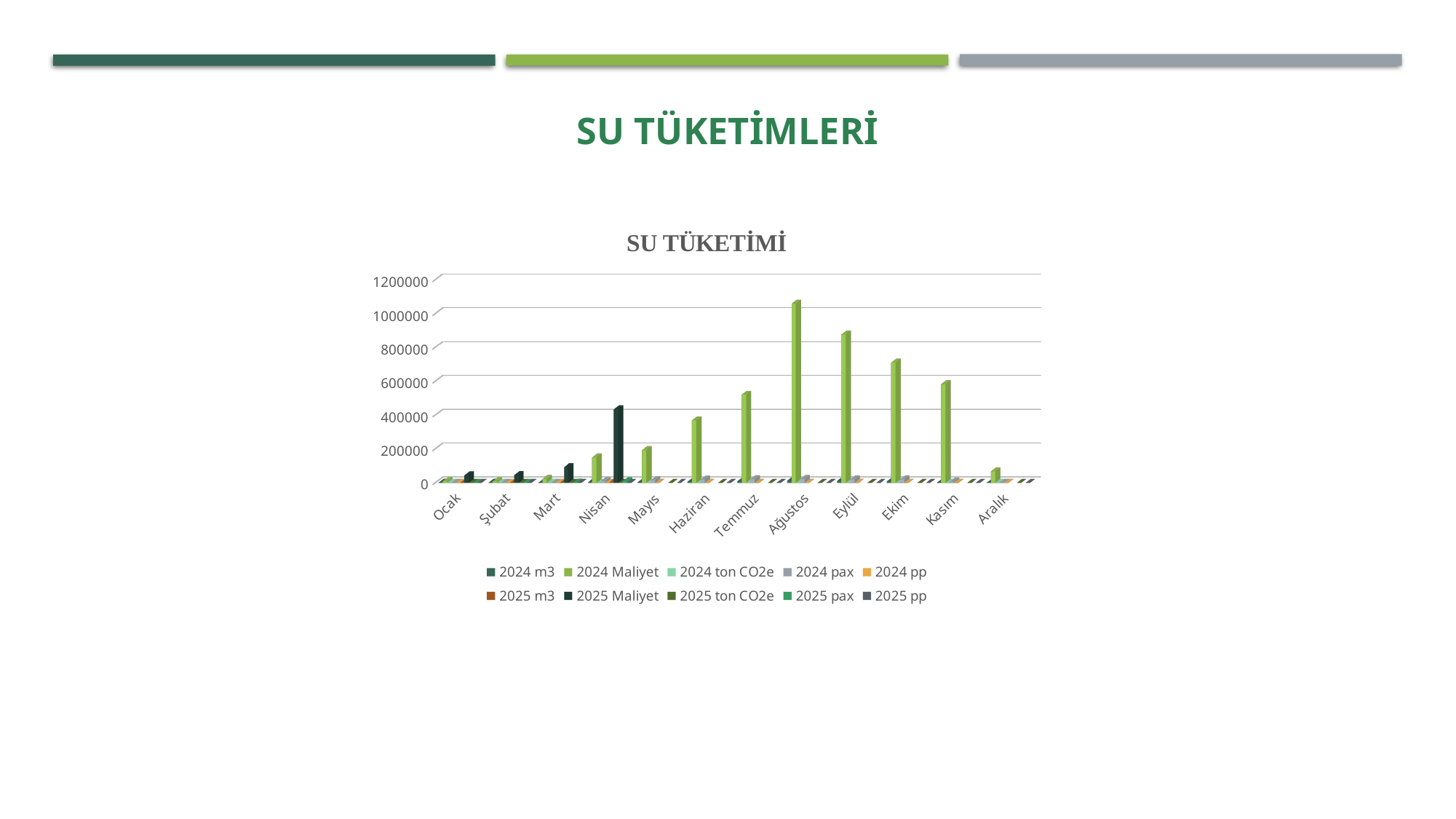
Do the 2024 Maliyet values rise or fall from Ağustos to Kasım? fall What is the title of the chart? SU TÜKETİMİ What kind of chart is shown on the slide? Bar chart How many series does the legend of the SU TÜKETİMİ chart list? 10 Which is larger, the 2024 Maliyet value for Eylül or for Ekim? Eylül In Nisan, which is larger, the 2024 Maliyet bar or the 2025 Maliyet bar? 2025 Maliyet Is the 2024 Maliyet value for Temmuz greater or less than 400000? greater Is the 2024 Maliyet value for Ekim greater or less than 800000? less Is the 2024 Maliyet value for Eylül greater or less than 800000? greater Which month has the highest 2024 Maliyet bar? Ağustos How many months are shown on the x axis of the SU TÜKETİMİ chart? 12